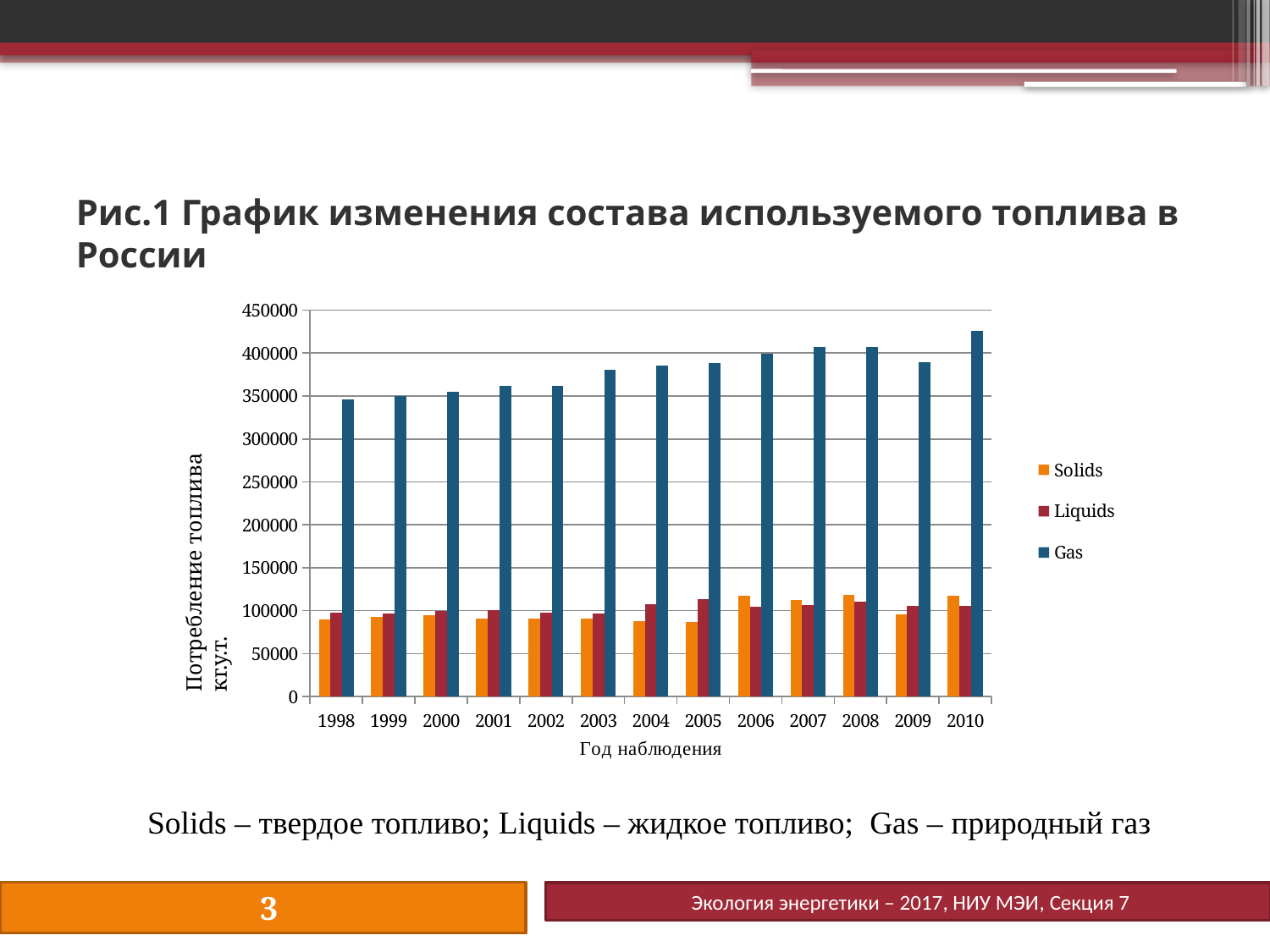
What kind of chart is shown on the slide? Bar chart What is the title of the x axis of the chart? Год наблюдения Does the Gas value generally rise or fall from 1998 to 2010? rise In which year is the Gas value lowest? 1998 Which series are listed in the chart's legend? Solids, Liquids, Gas How many series does the chart's legend list? 3 Which is larger in 2004, the Gas value or the Liquids value? Gas Is the Solids value for 2005 greater or less than 100000? less In which year is the Gas value highest? 2010 Is the Gas value for 2010 greater or less than 400000? greater How many years are shown along the x axis of the chart? 13